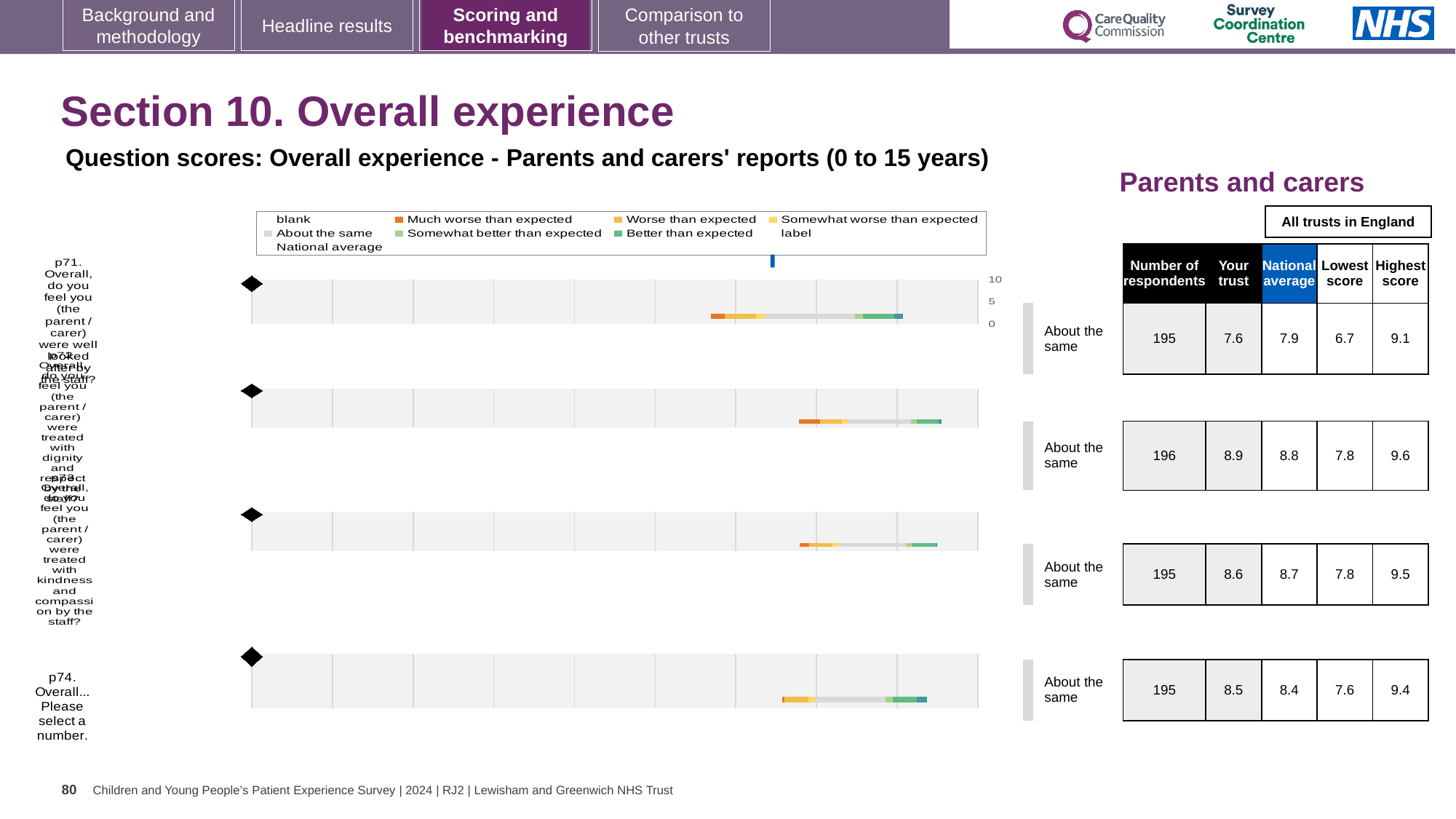
How many question rows are plotted in the chart? 4 What colour does the legend use for 'Much worse than expected'? orange What is the difference between the highest score and the lowest score for the first (top) question row? 2.4 Which question row has the lowest 'Your trust' score? the first (top) row (7.6) What kind of chart is used to show the question scores on this slide? bar chart What is the national average score for the first (top) question row? 7.9 What benchmark category is shown for the bottom row, p74? About the same What is the 'Your trust' score for the first (top) question row? 7.6 What is the 'Your trust' score for the bottom row, p74 'Overall... Please select a number'? 8.5 How many respondents are listed for the second question row? 196 Which question row has the highest 'Your trust' score? the second row (8.9) For the second question row, which is larger: the 'Your trust' score or the national average? Your trust (8.9)